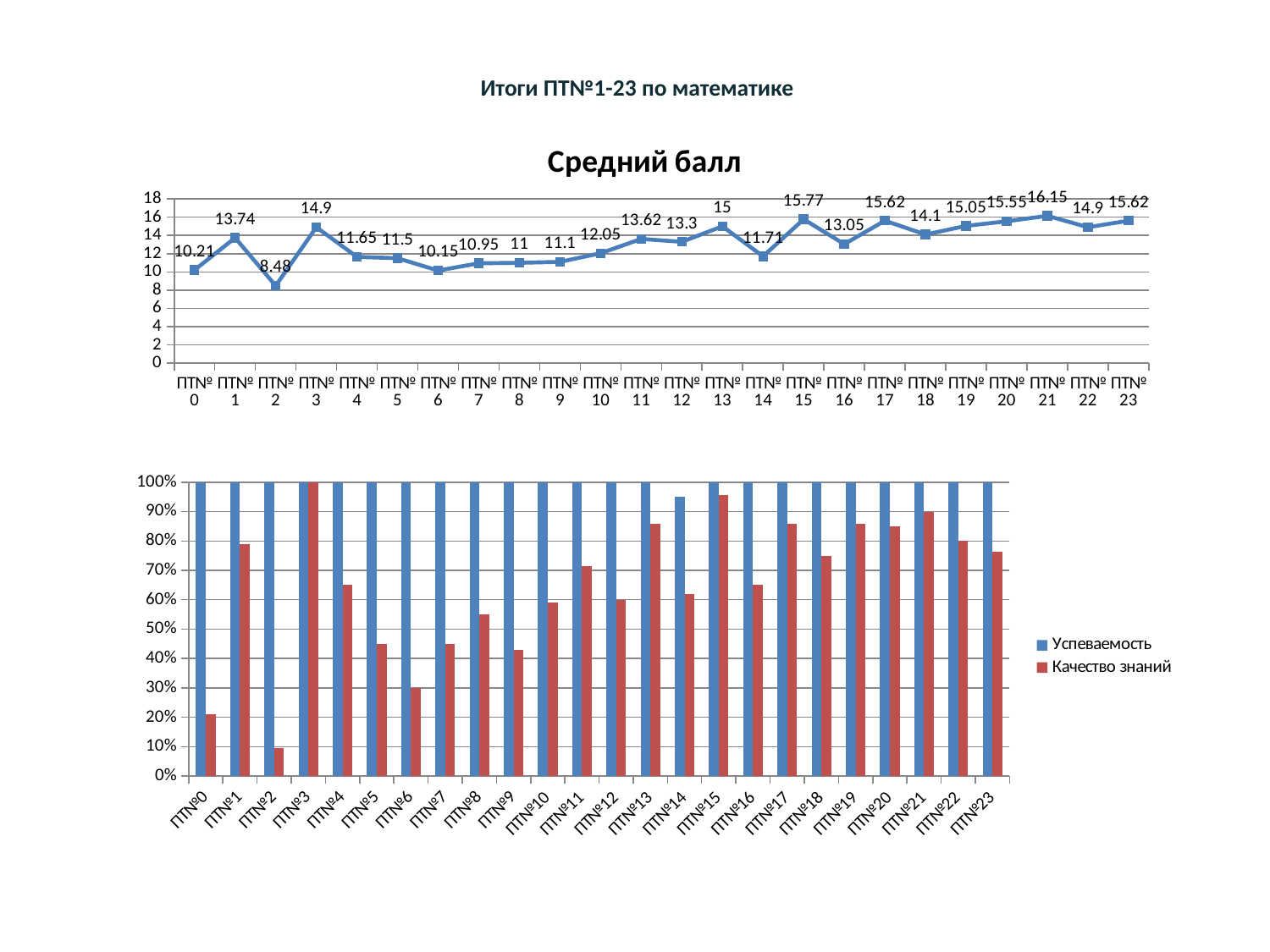
In the 'Средний балл' chart, which category has the highest value? ПТ№ 21 In the bottom chart, is the 'Качество знаний' value for ПТ№2 greater or less than 20%? less In the 'Средний балл' chart, what is the value for ПТ№ 0? 10.21 How many series does the legend of the bottom chart list? 2 In the 'Средний балл' chart, what is the value for ПТ№ 15? 15.77 In the 'Средний балл' chart, what is the difference between the values for ПТ№ 3 and ПТ№ 2? 6.42 In the 'Средний балл' chart, which is larger: the value for ПТ№ 11 or ПТ№ 12? ПТ№ 11 In the 'Средний балл' chart, which category has the lowest value? ПТ№ 2 What kind of chart is the bottom chart on the slide? Bar chart What kind of chart is the 'Средний балл' chart? Line chart How many data points are plotted in the 'Средний балл' chart? 24 In the bottom chart, is the 'Качество знаний' value for ПТ№13 greater or less than 80%? greater